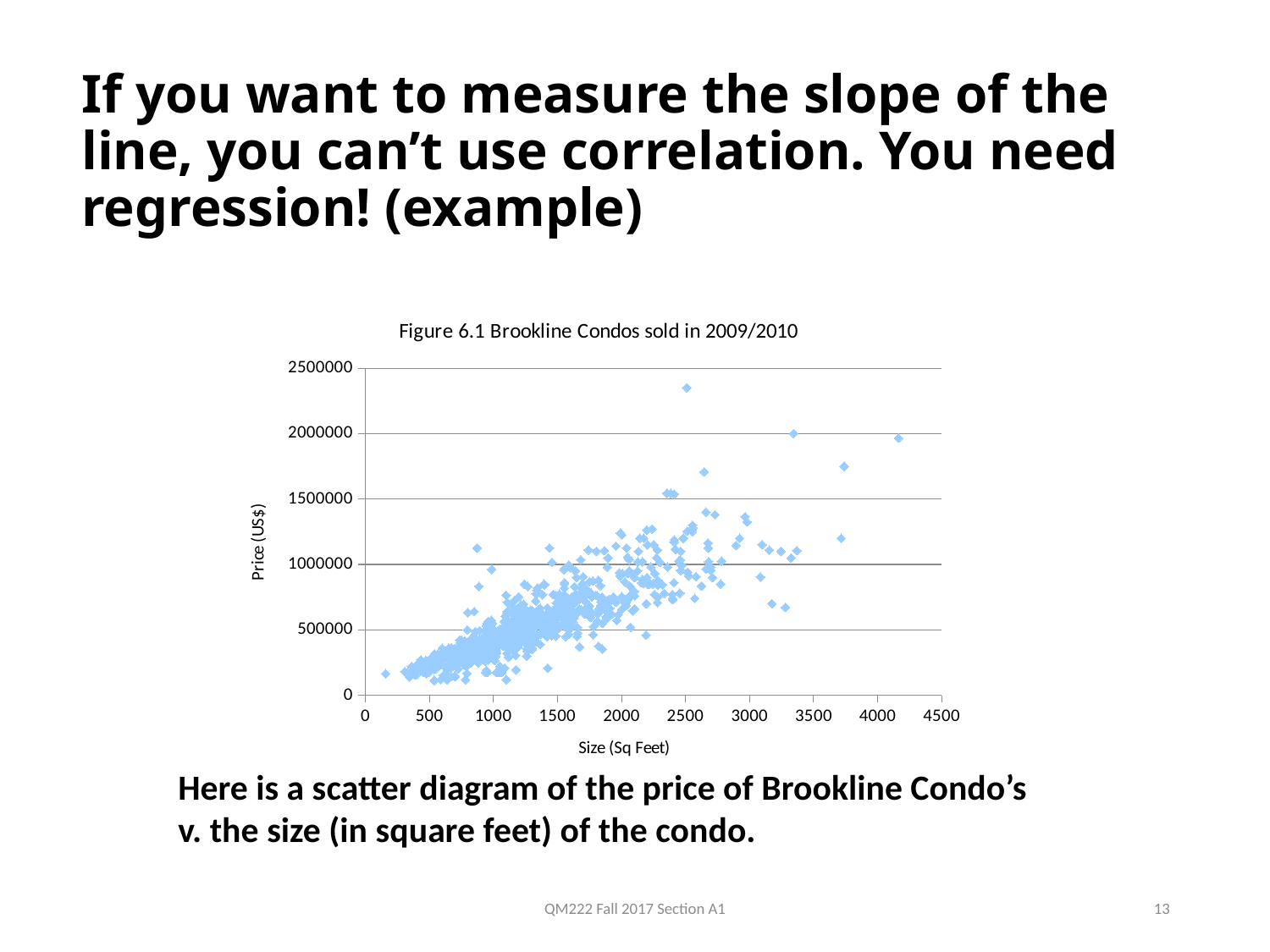
What is the title of the chart? Figure 6.1 Brookline Condos sold in 2009/2010 Is the size of the highest-priced condo greater or less than 2000 square feet? greater Is the size of the largest condo plotted greater or less than 4000 square feet? greater What is the label of the x axis? Size (Sq Feet) Is the price of the largest condo (around 4150 sq feet) greater or less than 1500000? greater What is the maximum value shown on the y axis? 2500000 What kind of chart is shown on the slide? scatter plot Do prices generally rise or fall as size increases along the x axis? rise